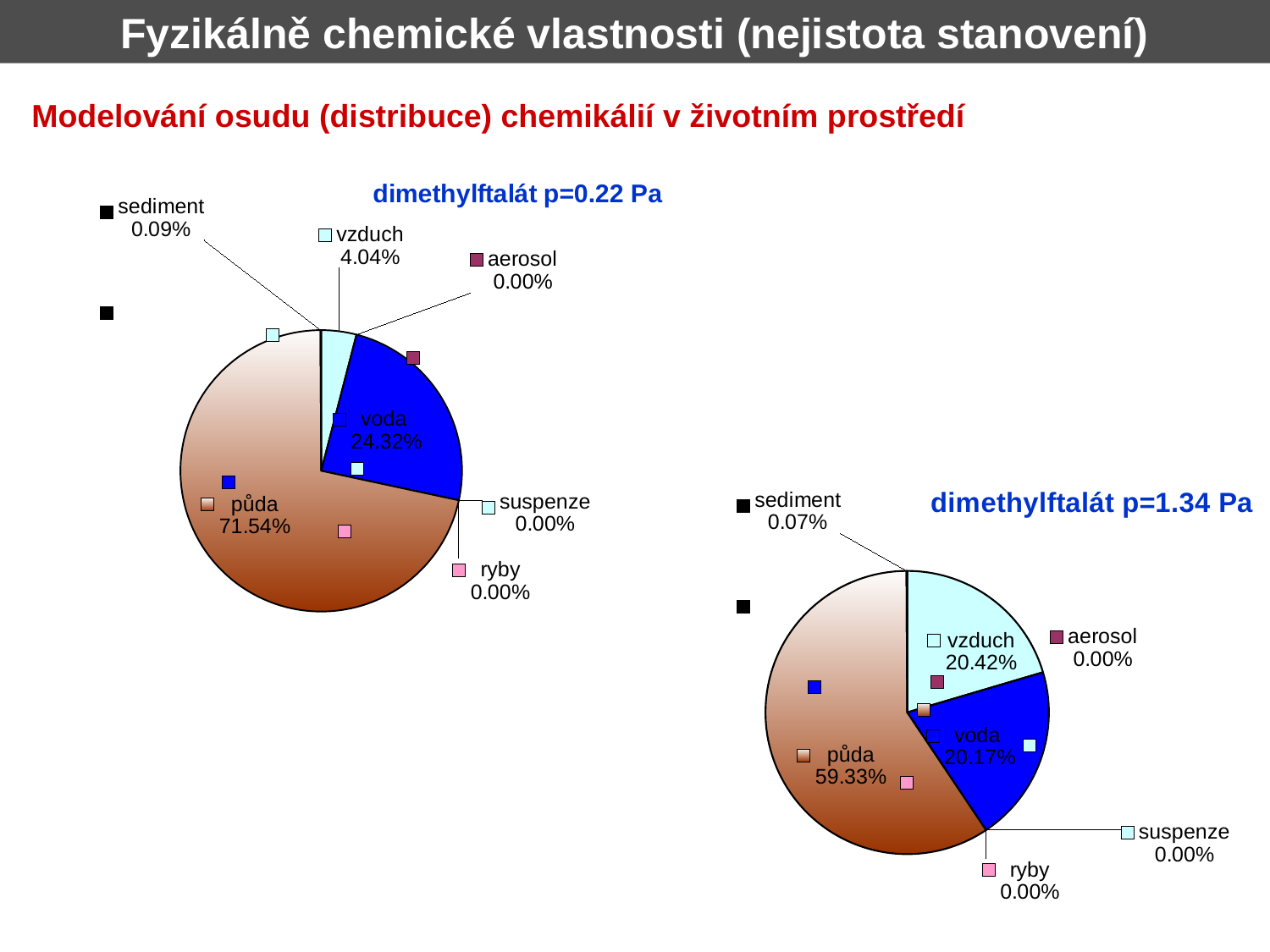
What is the title of the chart on the right side of the slide? dimethylftalát p=1.34 Pa In the chart titled "dimethylftalát p=1.34 Pa", what is the value for sediment? 0.07% How many categories are labelled in the chart titled "dimethylftalát p=1.34 Pa"? 7 In the chart titled "dimethylftalát p=0.22 Pa", what is the value for vzduch? 4.04% In the chart titled "dimethylftalát p=0.22 Pa", which category has the largest share? půda In the chart titled "dimethylftalát p=0.22 Pa", which is larger, the share of voda or the share of vzduch? voda What kind of chart is the chart titled "dimethylftalát p=0.22 Pa"? pie chart In the chart titled "dimethylftalát p=0.22 Pa", what share does voda have? 24.32% In the chart titled "dimethylftalát p=1.34 Pa", what is the difference between the shares of půda and voda? 39.16% In the chart titled "dimethylftalát p=0.22 Pa", what share does půda have? 71.54% In the chart titled "dimethylftalát p=1.34 Pa", what share does vzduch have? 20.42% In the chart titled "dimethylftalát p=1.34 Pa", which category has the largest share? půda